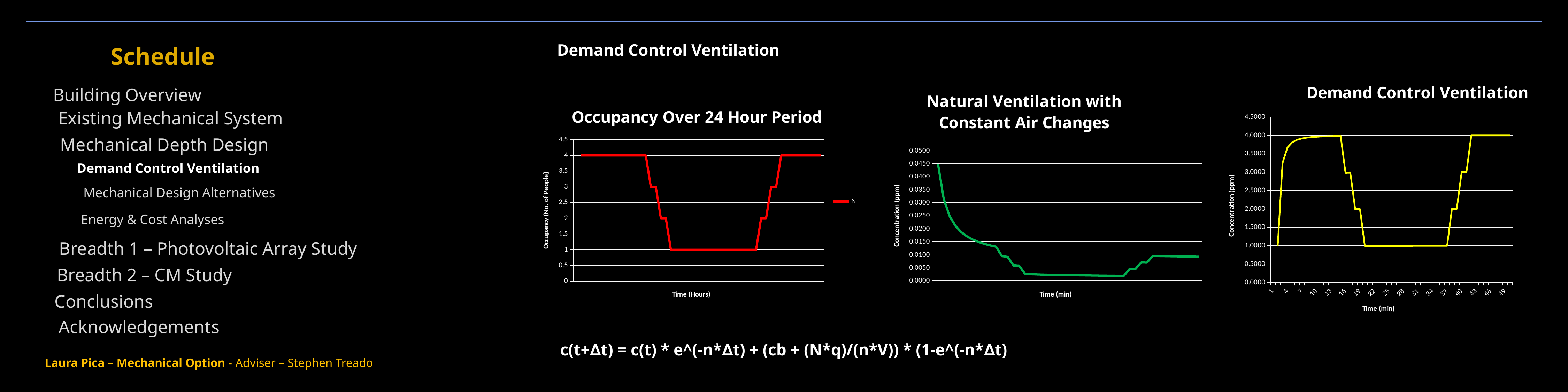
In the "Occupancy Over 24 Hour Period" chart, what is the lowest occupancy value the line reaches? 1 In the "Demand Control Ventilation" chart on the right, is the concentration at time 7 min greater or less than 3.5000? greater In the "Natural Ventilation with Constant Air Changes" chart, does the concentration mainly rise or fall over the first part of the time axis? fall In the "Occupancy Over 24 Hour Period" chart, what is the highest occupancy value the line reaches? 4 What kind of chart is the "Occupancy Over 24 Hour Period" chart? line chart How many series does the legend of the "Occupancy Over 24 Hour Period" chart list? 1 What is the y-axis title of the "Occupancy Over 24 Hour Period" chart? Occupancy (No. of People) What is the label of the series in the legend of the "Occupancy Over 24 Hour Period" chart? N In the "Natural Ventilation with Constant Air Changes" chart, is the lowest concentration value greater or less than 0.0050? less In the "Natural Ventilation with Constant Air Changes" chart, what is the concentration at the start of the line? 0.0450